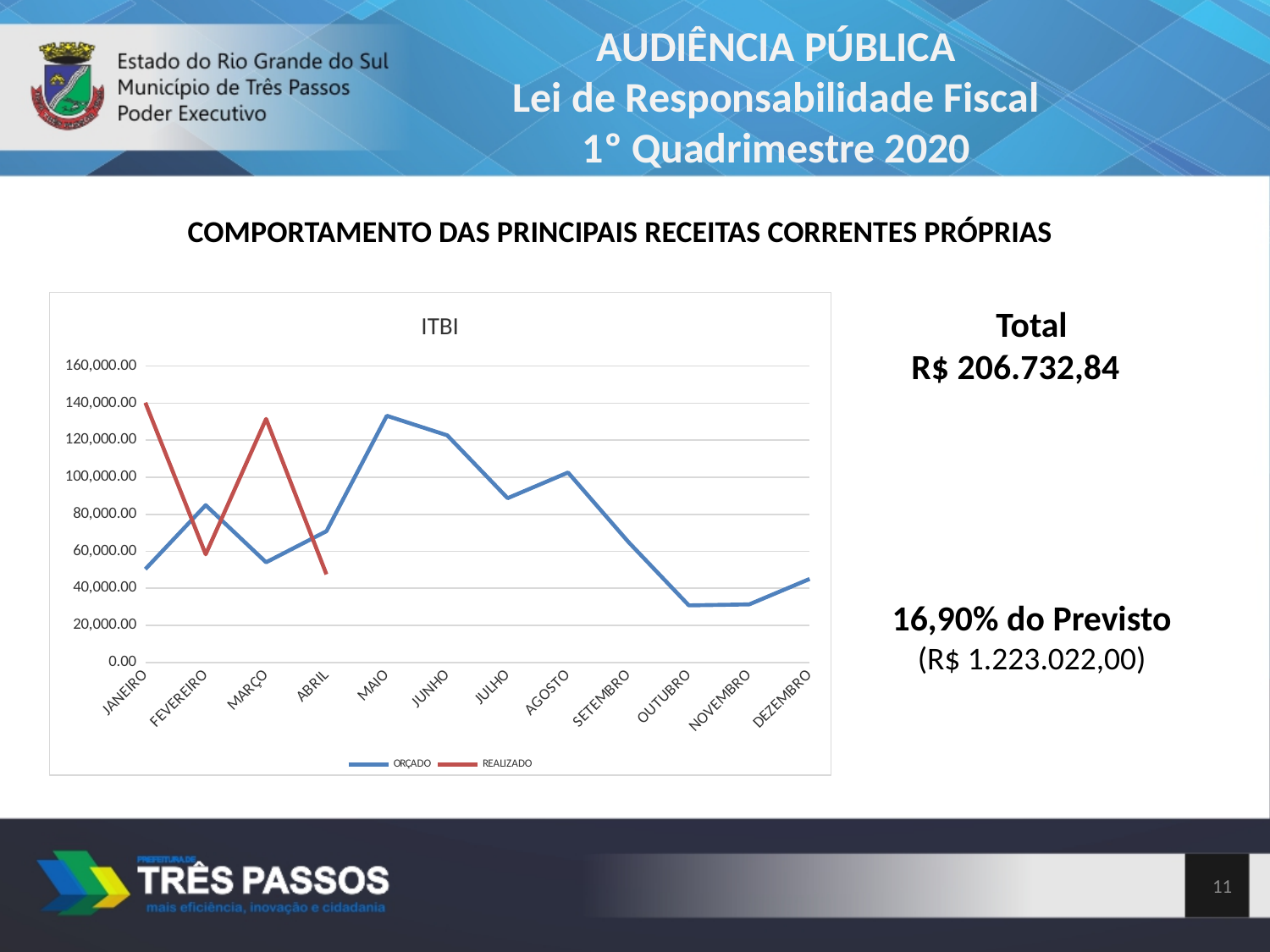
Does the ORÇADO series rise or fall from AGOSTO to OUTUBRO? fall Is the ORÇADO value for OUTUBRO greater or less than 40,000.00? less What is the title of the chart? ITBI In FEVEREIRO, which series has the larger value, ORÇADO or REALIZADO? ORÇADO In JANEIRO, which series has the larger value, ORÇADO or REALIZADO? REALIZADO In which month does the REALIZADO series reach its highest value? JANEIRO Is the ORÇADO value for MAIO greater or less than 120,000.00? greater How many months are shown on the x axis of the chart? 12 In which month does the ORÇADO series reach its highest value? MAIO What kind of chart is shown on the slide? line chart How many series does the chart legend list? 2 Is the REALIZADO value for ABRIL greater or less than 60,000.00? less